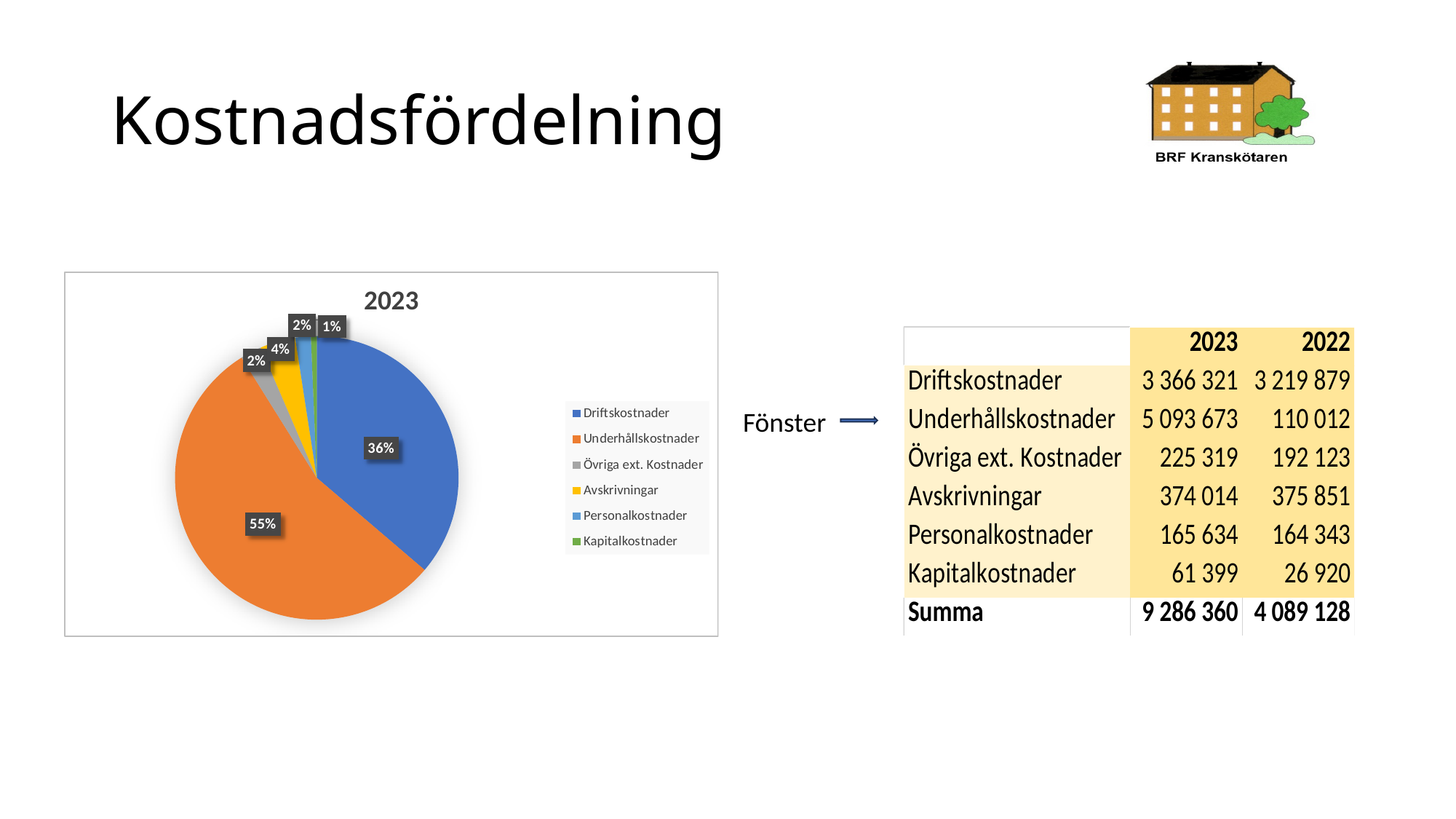
What share of the pie does Avskrivningar have? 4% Which category has the smallest slice of the pie chart? Kapitalkostnader What share of the pie does Driftskostnader have? 36% What is the title of the pie chart? 2023 What kind of chart is shown on the slide? pie chart What share of the pie does Underhållskostnader have? 55% What is the difference in percentage points between the Underhållskostnader slice and the Driftskostnader slice? 19 How many slices does the pie chart have? 6 Which slice is larger, Avskrivningar or Personalkostnader? Avskrivningar Which category has the largest slice of the pie chart? Underhållskostnader How many entries does the legend of the pie chart list? 6